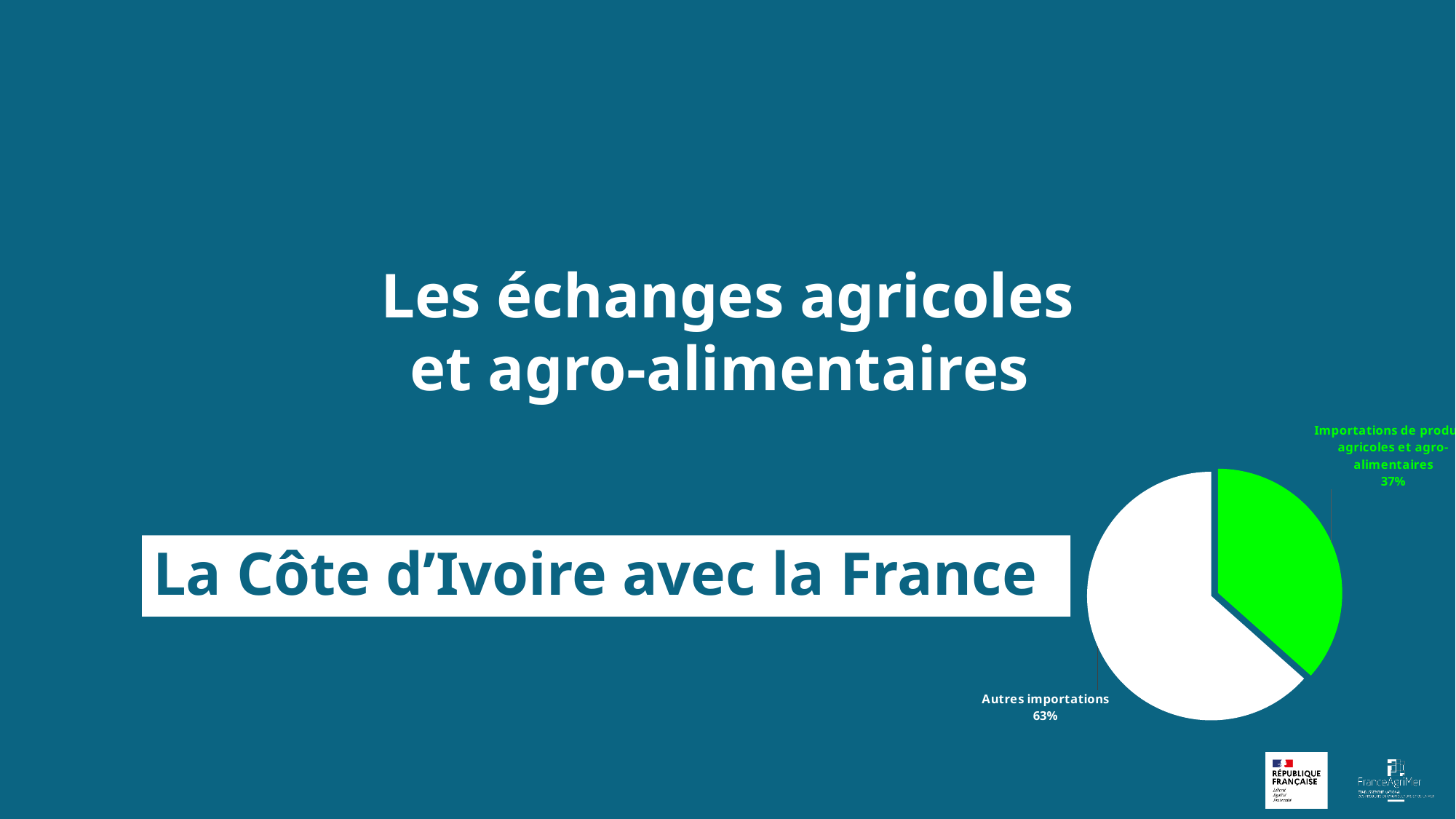
What share of the pie does the green slice for agricultural and agri-food imports ("agricoles et agro-alimentaires") represent? 37% What share of the pie does the "Autres importations" slice represent? 63% How many slices does the pie chart have? 2 What is the difference in percentage points between the "Autres importations" slice and the agricultural and agri-food imports slice? 26 Which slice of the pie chart is the smallest? Importations de produits agricoles et agro-alimentaires Which slice of the pie chart is the largest? Autres importations Is the share for "Autres importations" greater or less than 50%? greater What colour is the slice for agricultural and agri-food imports? green What colour is the "Autres importations" slice? white Which is larger: the "Autres importations" slice or the agricultural and agri-food imports slice? Autres importations What kind of chart is shown on the slide? pie chart